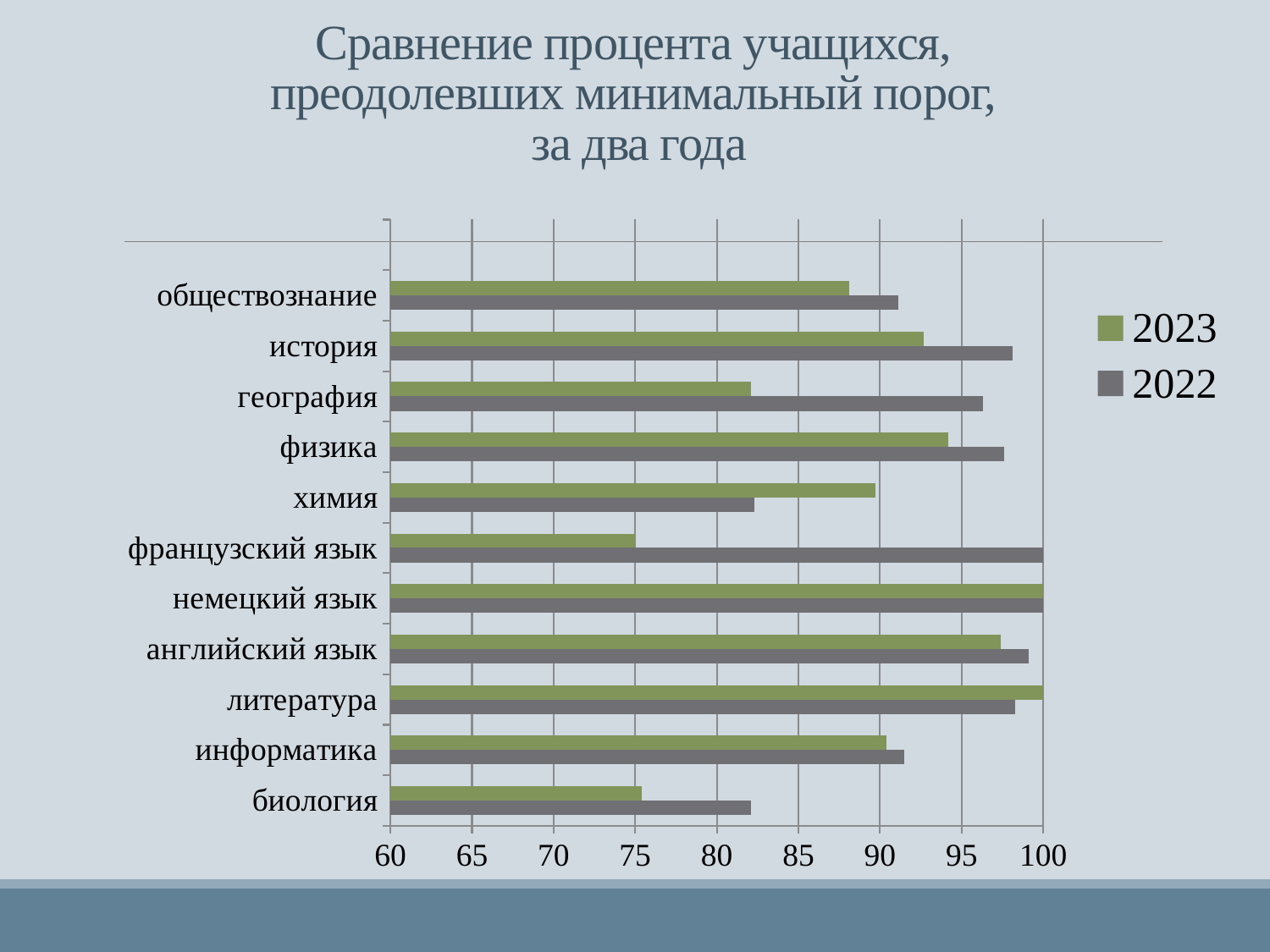
For химия, which year has the larger value, 2023 or 2022? 2023 What is the value for немецкий язык in 2023? 100 Is the value for обществознание in 2023 greater or less than 90? less What kind of chart is shown on the slide? bar chart Is the value for биология in 2023 greater or less than 80? less For французский язык, which year has the larger value, 2023 or 2022? 2022 What is the value for французский язык in 2022? 100 How many series does the legend list? 2 In 2023, which has the larger value, физика or география? физика Which colour represents the 2023 series in the legend? green Is the value for география in 2022 greater or less than 95? greater How many subjects (categories) are plotted on the chart? 11